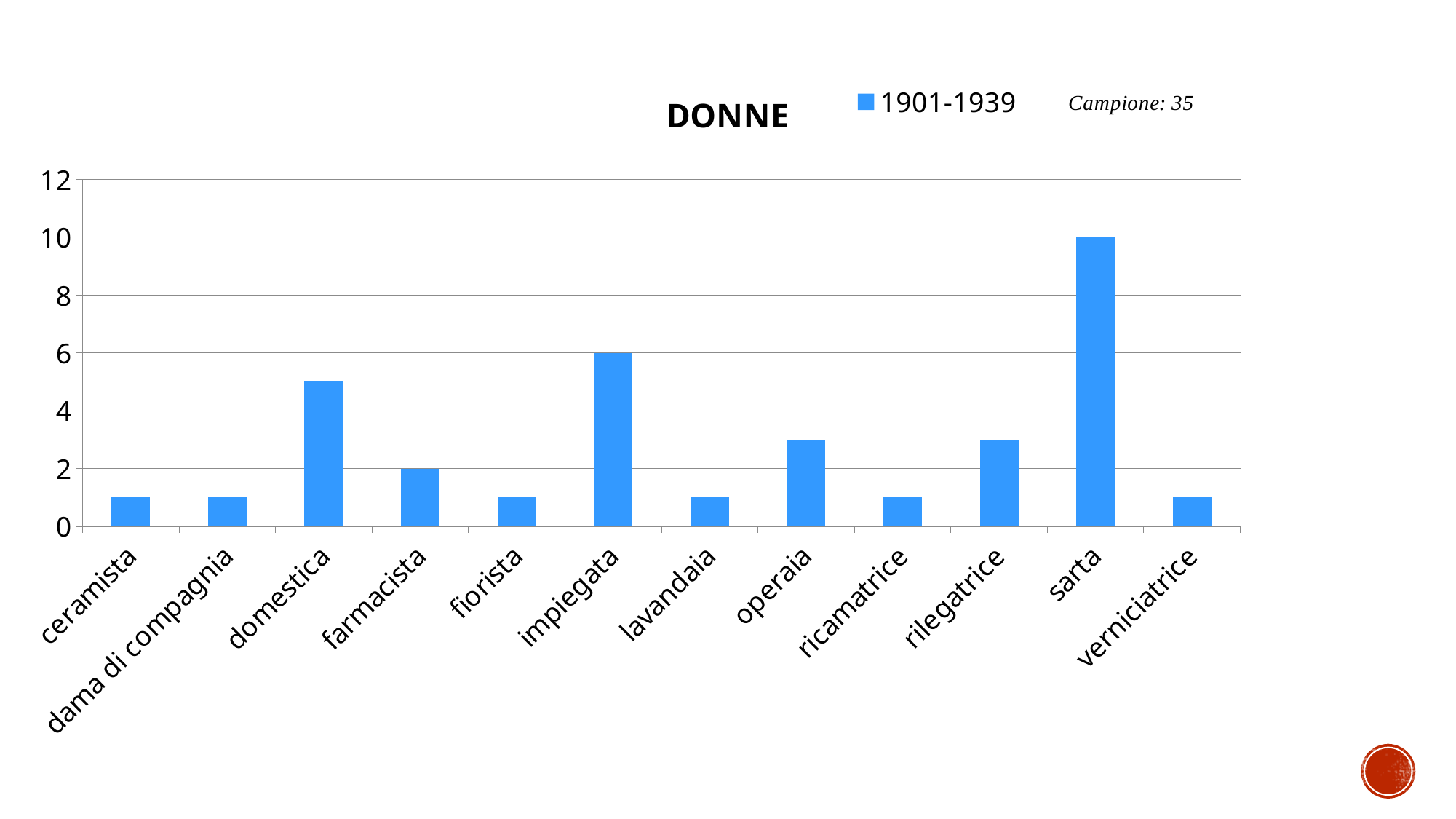
How many categories are shown on the x axis? 12 What kind of chart is shown on the slide? bar chart Is the value for domestica greater or less than 4? greater What is the value for farmacista? 2 What is the difference between the values for sarta and impiegata? 4 What is the value for sarta? 10 What is the title of the chart? DONNE Which is larger, the value for impiegata or the value for domestica? impiegata What is the value for impiegata? 6 How many series does the legend list? 1 Which category has the highest value? sarta What series does the legend list? 1901-1939